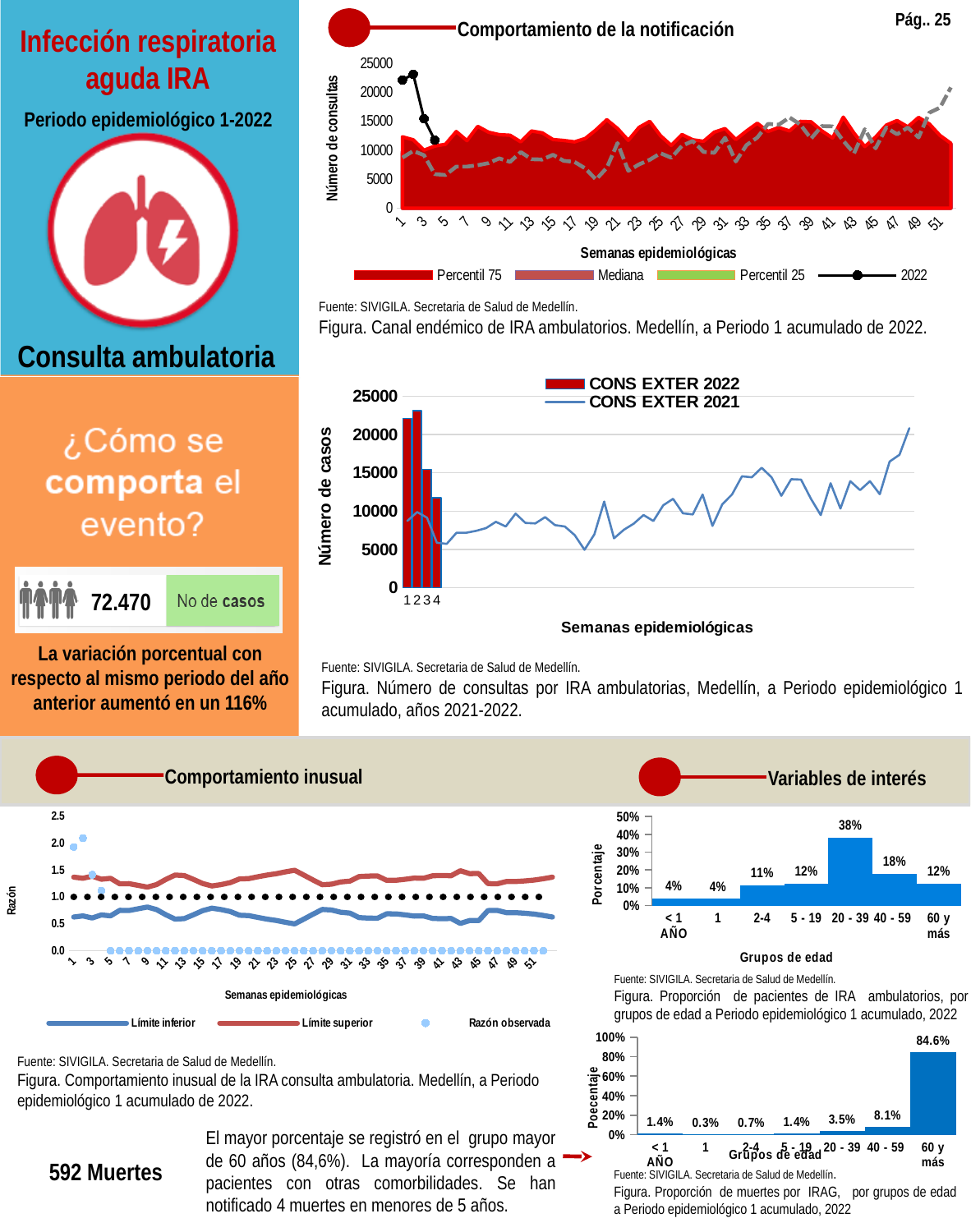
In the chart 'Proporción de muertes por IRAG, por grupos de edad', what is the difference between the 60 y más group and the 40 - 59 group? 76.5% In the chart 'Proporción de pacientes de IRA ambulatorios, por grupos de edad', what percentage is shown for the 20 - 39 age group? 38% In the chart 'Proporción de pacientes de IRA ambulatorios, por grupos de edad', how many age groups are shown on the x axis? 7 In the chart 'Proporción de muertes por IRAG, por grupos de edad', what percentage is shown for the 60 y más group? 84.6% In the chart 'Comportamiento inusual de la IRA consulta ambulatoria' at the bottom left, how many series does the legend list? 3 What kind of chart is 'Proporción de muertes por IRAG, por grupos de edad'? Bar chart In the chart 'Proporción de pacientes de IRA ambulatorios, por grupos de edad', what is the difference between the 20 - 39 group and the 40 - 59 group? 20% In the chart 'Canal endémico de IRA ambulatorios' at the top right, how many series does the legend list? 4 In the chart 'Número de consultas por IRA ambulatorias, años 2021-2022', is the CONS EXTER 2022 value for week 2 greater or less than 20000? greater In the chart 'Proporción de pacientes de IRA ambulatorios, por grupos de edad', which is larger: the value for 2-4 or the value for 5 - 19? 5 - 19 In the chart 'Proporción de muertes por IRAG, por grupos de edad', which age group has the lowest percentage? 1 In the chart 'Proporción de pacientes de IRA ambulatorios, por grupos de edad', which age group has the highest percentage? 20 - 39